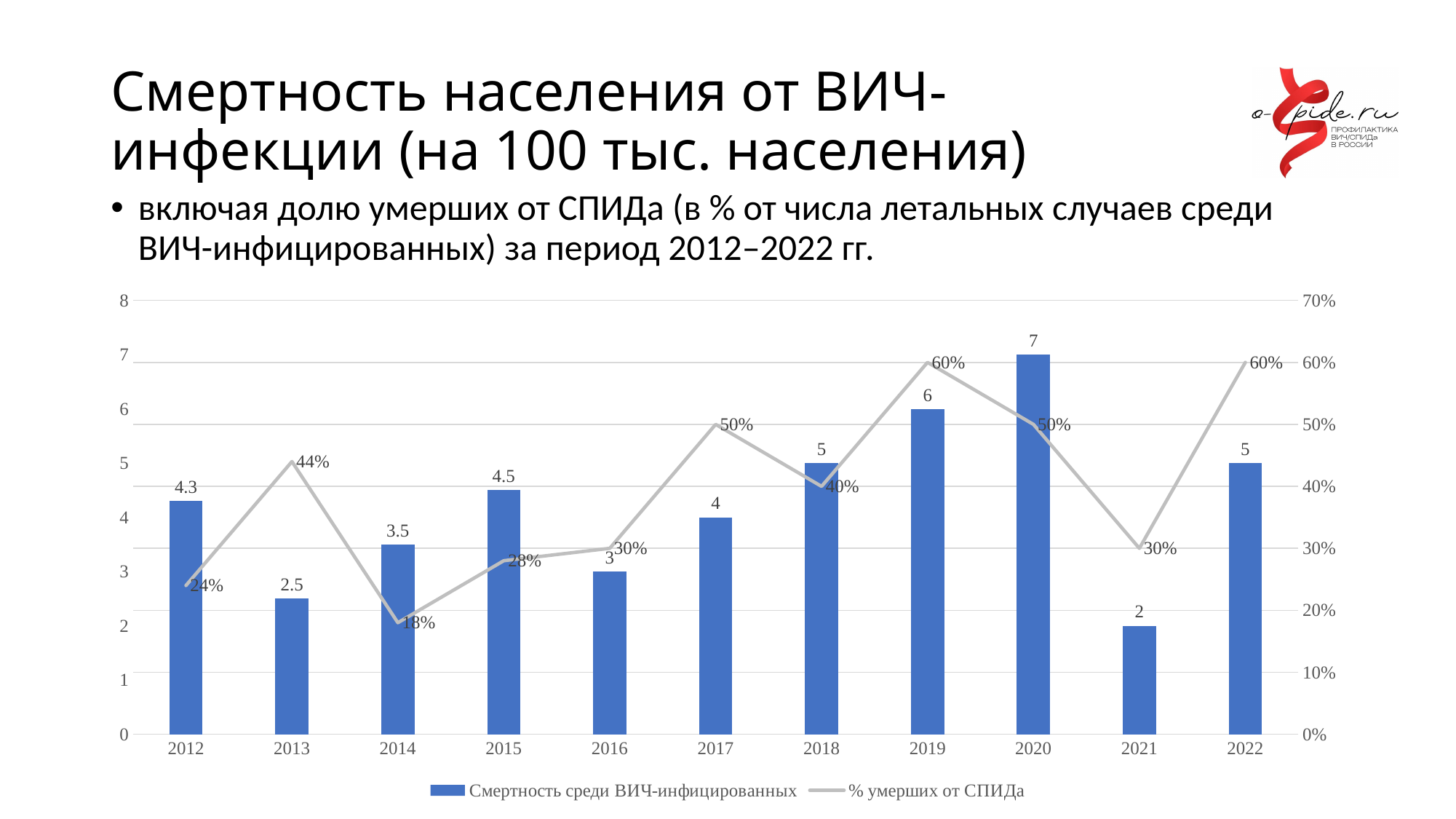
Which year has the highest value in the bar series 'Смертность среди ВИЧ-инфицированных'? 2020 How many years are shown on the x axis of the chart? 11 Which year has the lowest value in the bar series 'Смертность среди ВИЧ-инфицированных'? 2021 What kind of chart is shown on the slide? Combined bar and line chart What is the value of the line series '% умерших от СПИДа' for 2013? 44% How many series does the chart legend list? 2 What is the value of the bar series 'Смертность среди ВИЧ-инфицированных' for 2012? 4.3 Which year has a larger bar value, 2015 or 2016? 2015 What is the value of the bar series 'Смертность среди ВИЧ-инфицированных' for 2020? 7 Which year has the lowest value in the line series '% умерших от СПИДа'? 2014 What is the difference between the bar values for 2020 and 2021? 5 What is the value of the line series '% умерших от СПИДа' for 2014? 18%